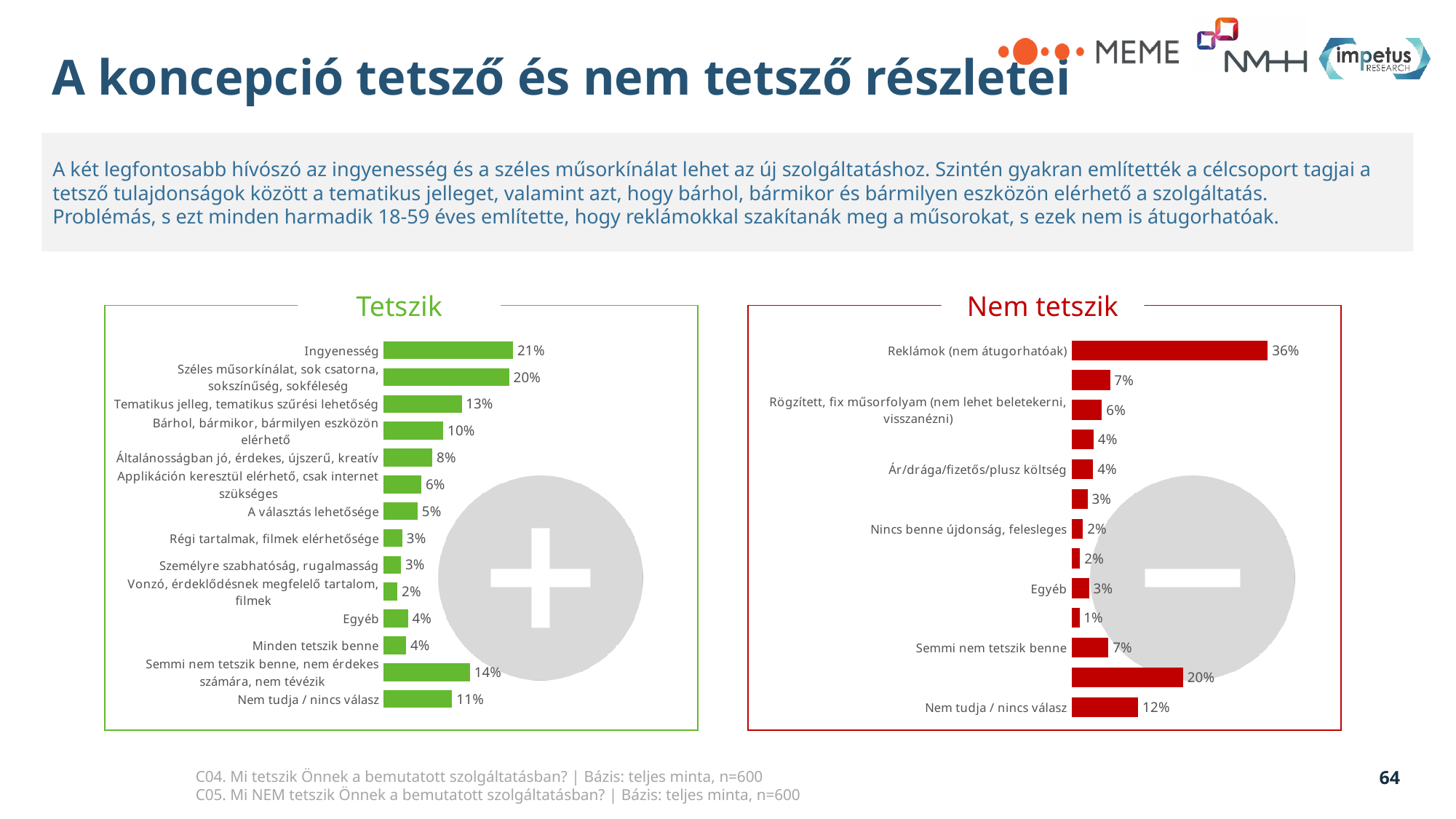
In the 'Nem tetszik' chart, what is the value for Reklámok (nem átugorhatóak)? 36% In the 'Nem tetszik' chart, what is the value for Nem tudja / nincs válasz? 12% In the 'Tetszik' chart, which category has the highest value? Ingyenesség What colour are the bars in the 'Tetszik' chart? Green In the 'Tetszik' chart, what is the difference between Ingyenesség and Nem tudja / nincs válasz? 10% How many categories are shown in the 'Tetszik' chart? 14 In the 'Nem tetszik' chart, which category has the highest value? Reklámok (nem átugorhatóak) In the 'Tetszik' chart, what is the value for Ingyenesség? 21% In the 'Tetszik' chart, which is larger: Bárhol, bármikor, bármilyen eszközön elérhető or Általánosságban jó, érdekes, újszerű, kreatív? Bárhol, bármikor, bármilyen eszközön elérhető In the 'Nem tetszik' chart, what is the difference between Reklámok (nem átugorhatóak) and Semmi nem tetszik benne? 29% What kind of chart is the 'Nem tetszik' chart? Bar chart In the 'Tetszik' chart, what is the value for Tematikus jelleg, tematikus szűrési lehetőség? 13%